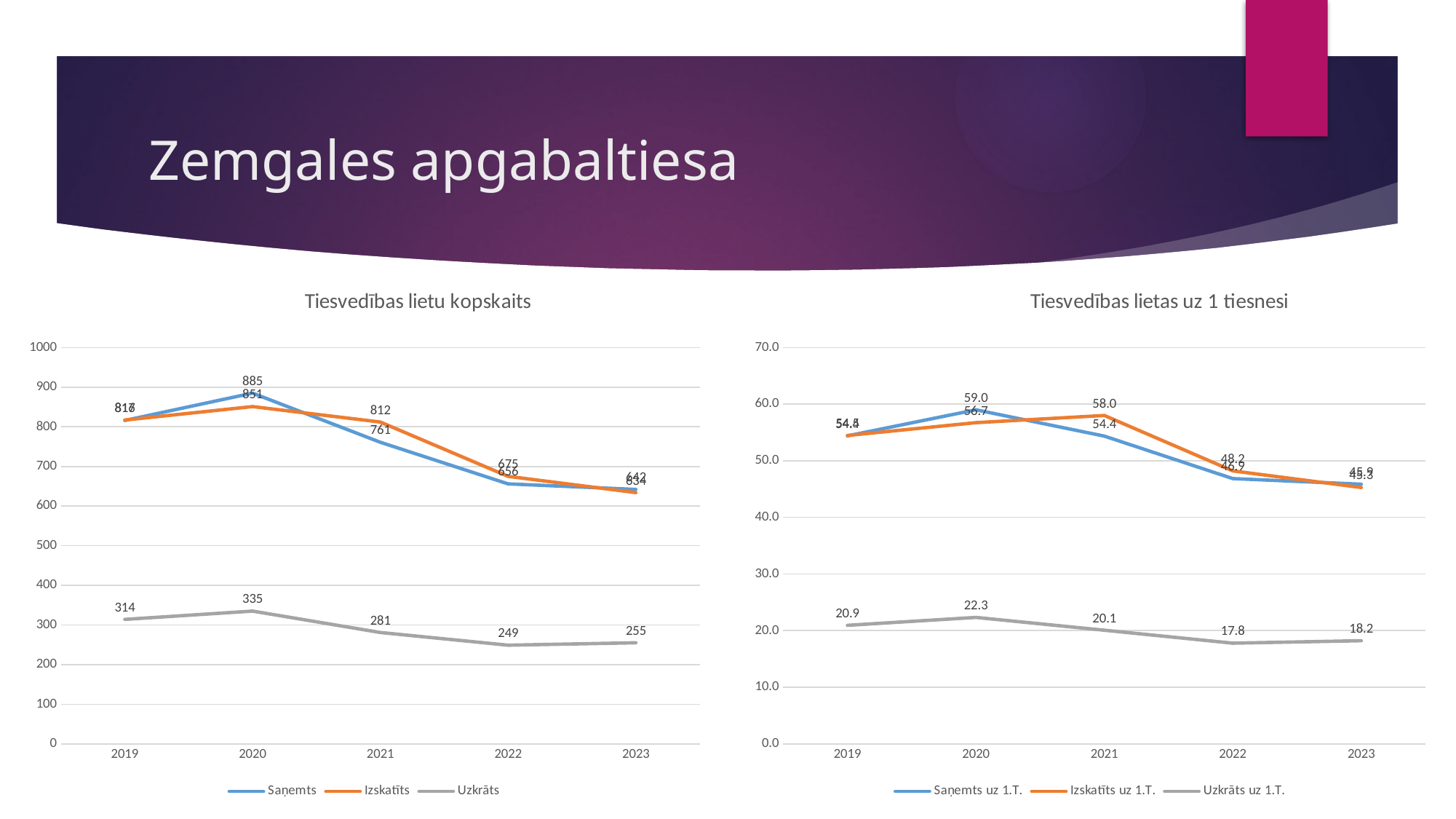
In the chart titled "Tiesvedības lietu kopskaits", in which year is Uzkrāts highest? 2020 In the chart titled "Tiesvedības lietu kopskaits", what is the value of Saņemts in 2020? 885 In the chart titled "Tiesvedības lietas uz 1 tiesnesi", is the value of Saņemts uz 1.T. in 2022 greater or less than 50.0? less In the chart titled "Tiesvedības lietas uz 1 tiesnesi", what is the difference between Saņemts uz 1.T. and Izskatīts uz 1.T. in 2020? 2.3 In the chart titled "Tiesvedības lietas uz 1 tiesnesi", what is the value of Uzkrāts uz 1.T. in 2022? 17.8 In the chart titled "Tiesvedības lietas uz 1 tiesnesi", what is the value of Izskatīts uz 1.T. in 2021? 58.0 In the chart titled "Tiesvedības lietu kopskaits", what is the difference between Izskatīts and Saņemts in 2022? 19 In the chart titled "Tiesvedības lietu kopskaits", in which year is Uzkrāts lowest? 2022 In the chart titled "Tiesvedības lietu kopskaits", how many series does the legend list? 3 In the chart titled "Tiesvedības lietu kopskaits", what is the value of Izskatīts in 2021? 812 What kind of chart is the chart titled "Tiesvedības lietas uz 1 tiesnesi"? Line chart In the chart titled "Tiesvedības lietu kopskaits", which is larger in 2021: Saņemts or Izskatīts? Izskatīts